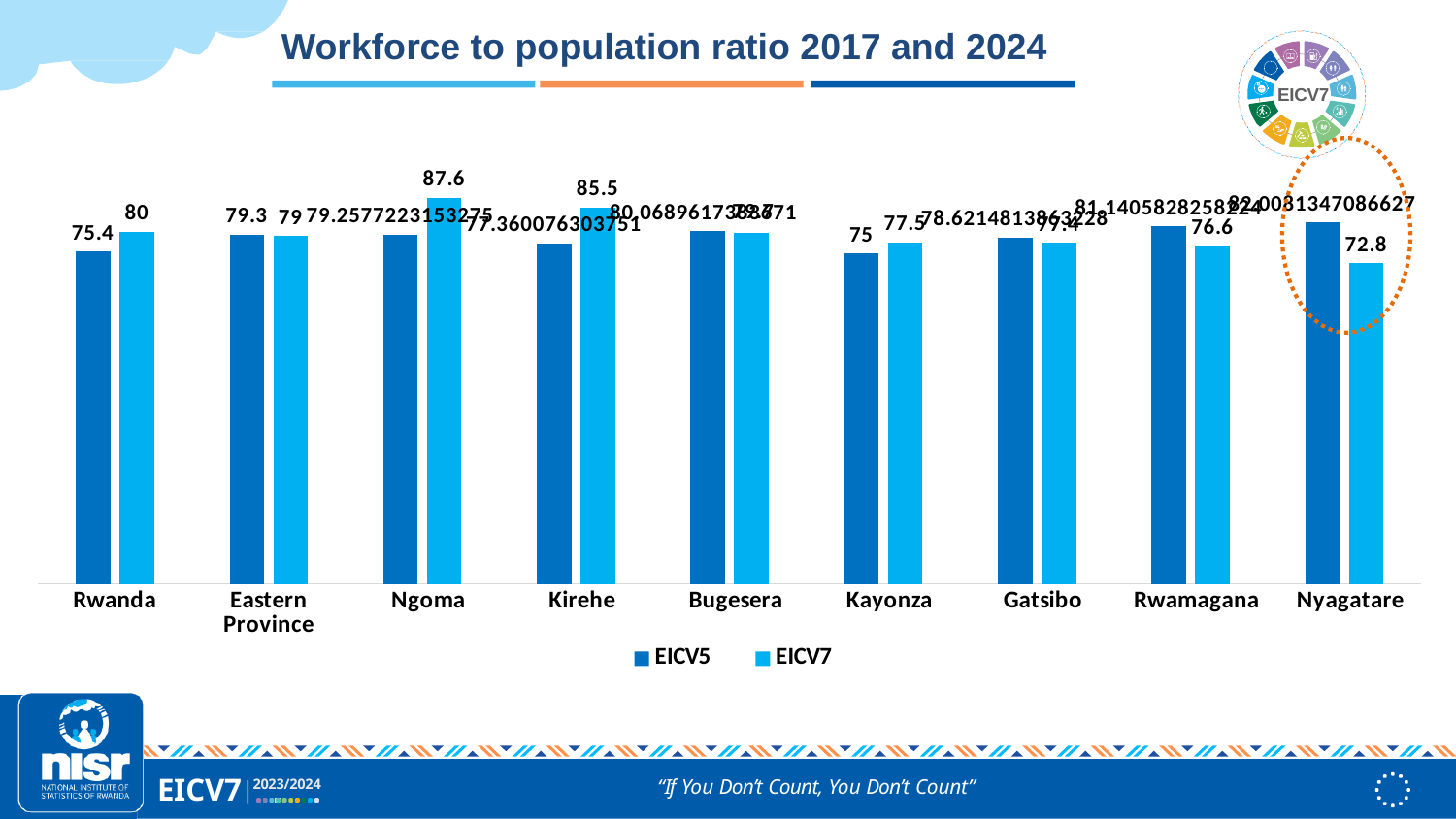
What is the EICV5 value for Rwanda? 75.4 Which category has the highest EICV7 value? Ngoma What is the EICV7 value for Kirehe? 85.5 What is the EICV7 value for Nyagatare? 72.8 What is the difference between the EICV7 and EICV5 values for Kayonza? 2.5 How many series does the legend list? 2 What is the difference between the EICV7 and EICV5 values for Rwanda? 4.6 What kind of chart is shown on the slide? Bar chart For Nyagatare, which series has the larger value, EICV5 or EICV7? EICV5 How many categories are shown on the x axis? 9 Which category has the lowest EICV7 value? Nyagatare What is the EICV7 value for Ngoma? 87.6